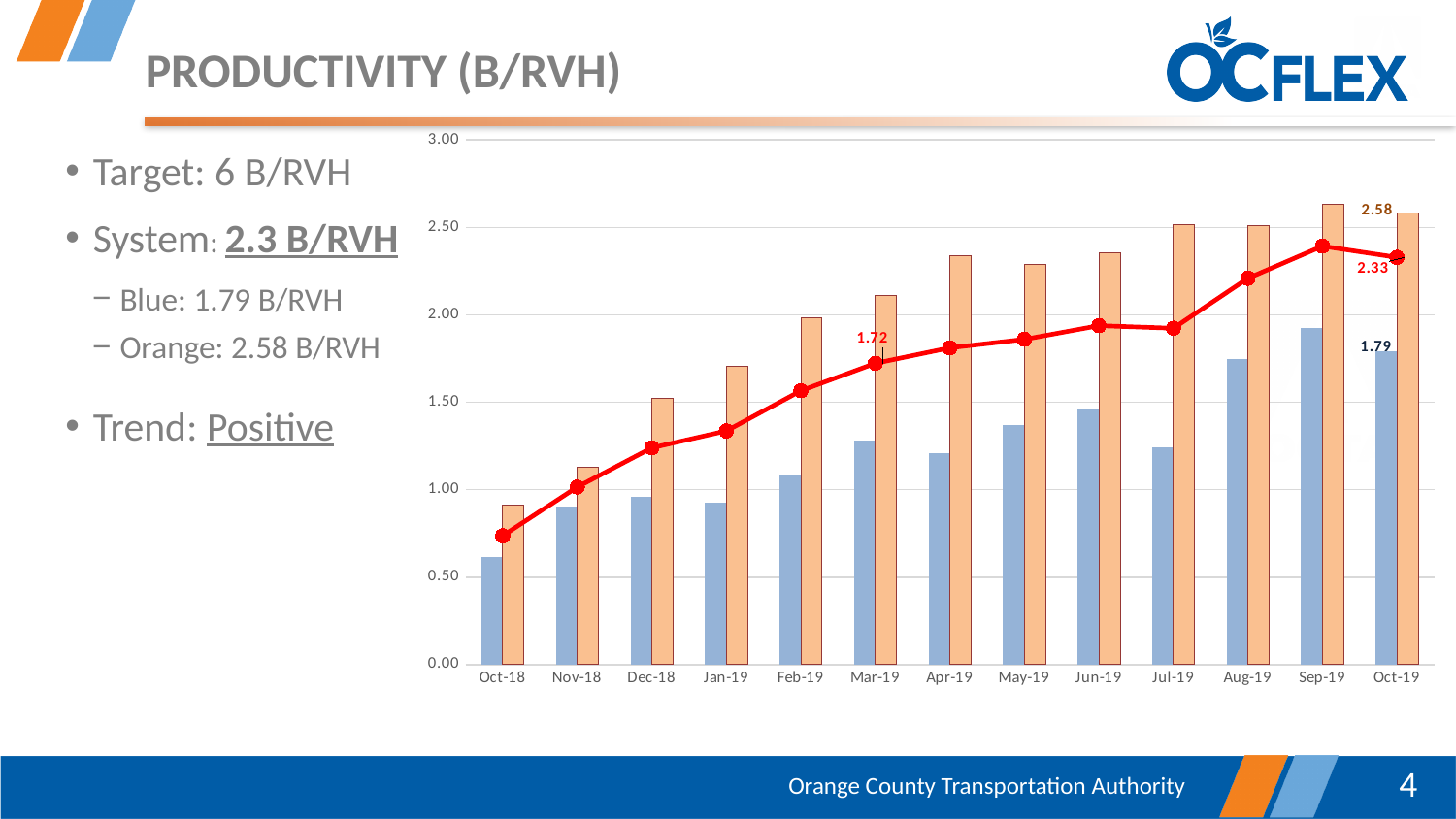
What kind of chart is shown on the slide? A combination bar and line chart Does the red line generally rise or fall from Oct-18 to Oct-19? rise Is the value of the orange bar for Apr-19 greater or less than 2.00? greater Which month has the lowest blue bar? Oct-18 What is the difference between the orange bar and the blue bar at Oct-19? 0.79 What is the value of the red line at Oct-19? 2.33 What is the value of the blue bar at Oct-19? 1.79 How many months are shown along the x axis of the chart? 13 Is the value of the orange bar for Oct-18 greater or less than 1.00? less What is the value of the red line at Mar-19? 1.72 What is the value of the orange bar at Oct-19? 2.58 By how much did the red line increase from Mar-19 to Oct-19? 0.61